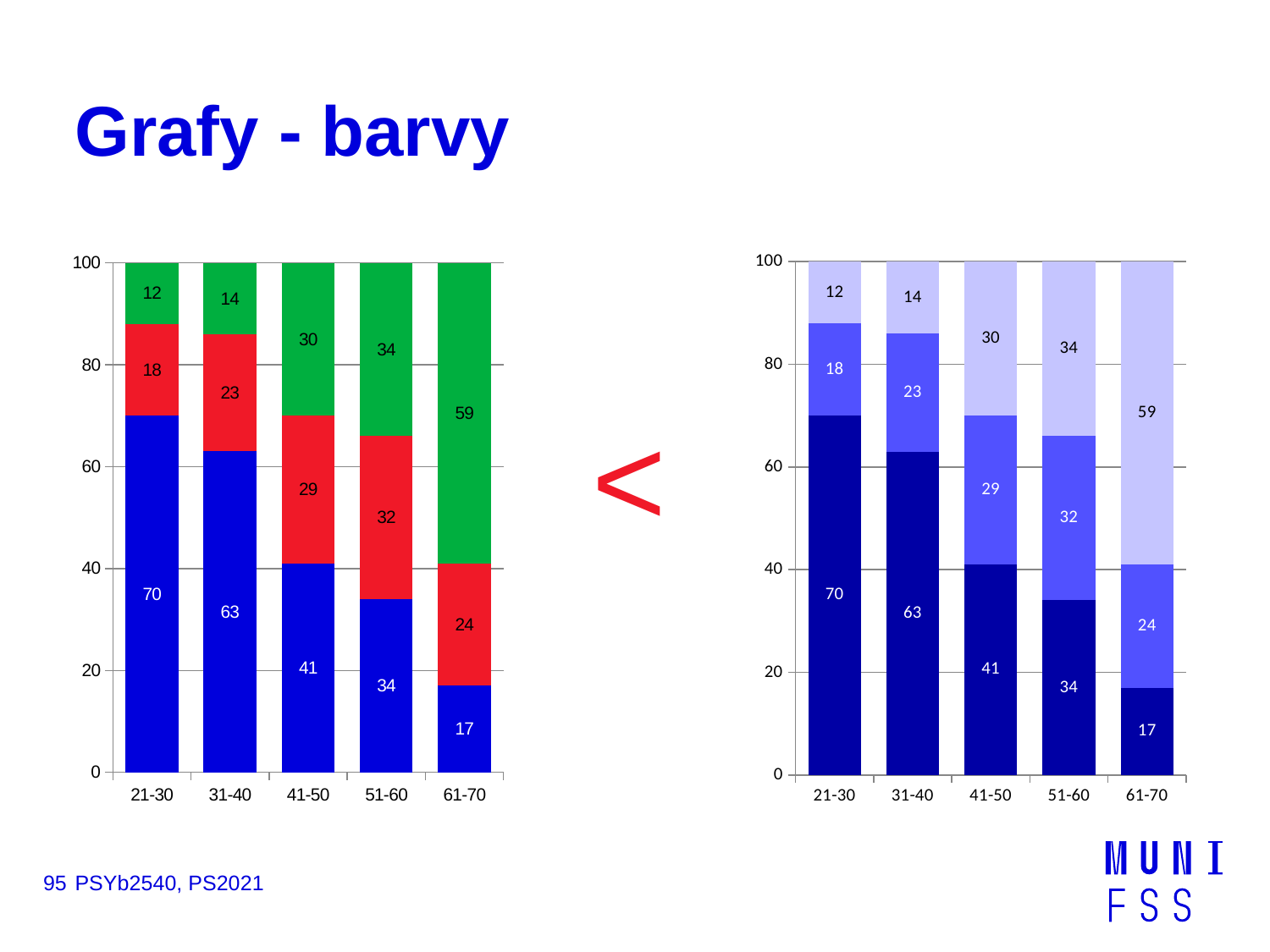
In the left chart, which category has the largest bottom (blue) segment? 21-30 In the left chart, do the bottom (blue) segment values rise or fall from 21-30 to 61-70? Fall In the left chart, what is the value of the middle (red) segment for the 51-60 category? 32 In the right chart, what is the total of the stacked bar for the 41-50 category? 100 In the right chart, what is the value of the top (lightest) segment for the 61-70 category? 59 What type of chart is shown on the right side of the slide? Stacked bar chart In the left chart, what is the value of the bottom (blue) segment for the 21-30 category? 70 In the left chart, what is the difference between the bottom (blue) segment values for 21-30 and 61-70? 53 What is the title of the slide? Grafy - barvy In the right chart, which category has the smallest top (lightest) segment? 21-30 In the right chart, which is larger: the middle segment for 41-50 or the middle segment for 31-40? 41-50 How many categories are shown on the x axis of the left chart? 5